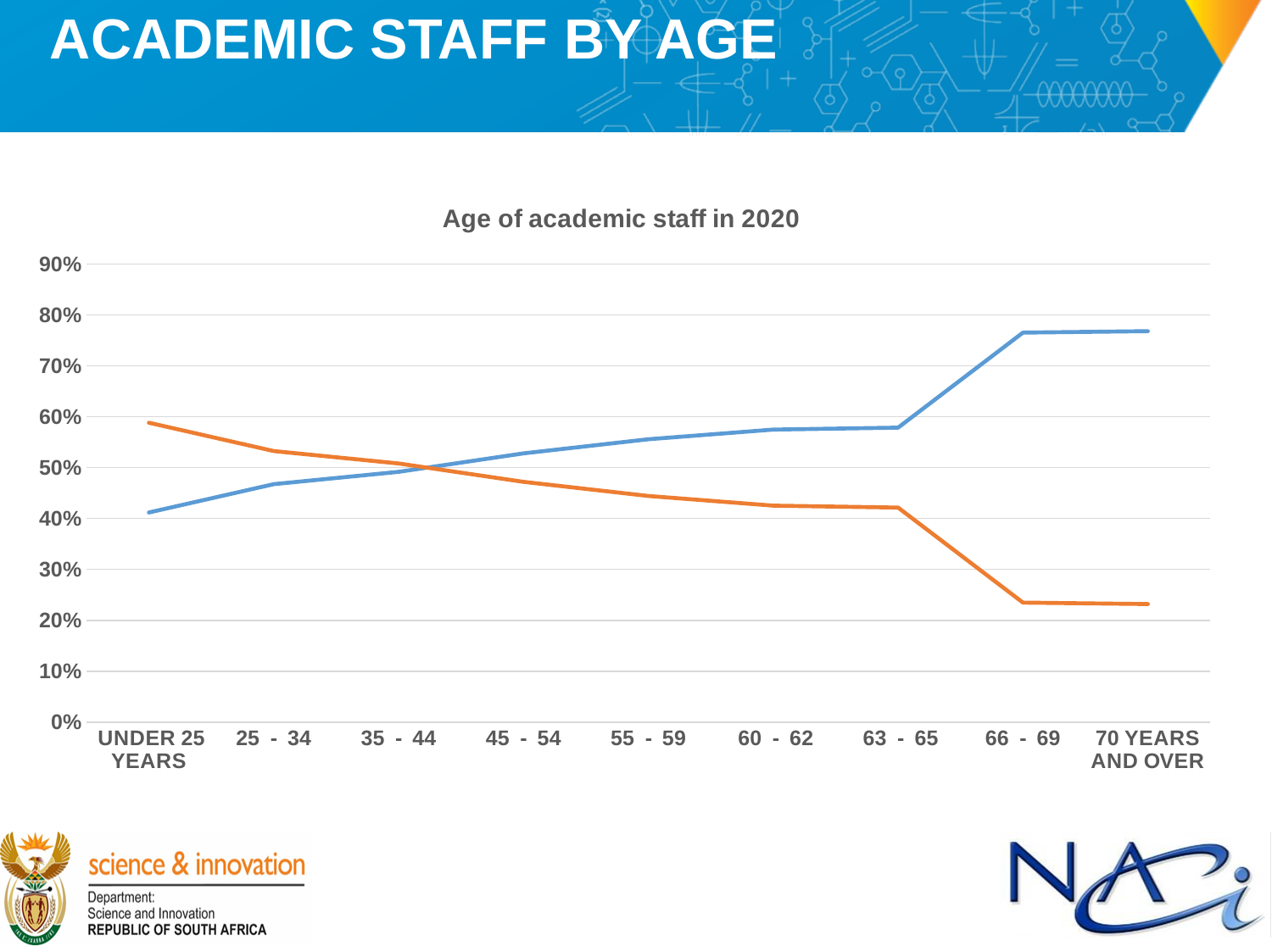
For which age category is the orange line at its highest? UNDER 25 YEARS Is the value of the blue line for 66 - 69 greater or less than 70%? greater Is the value of the blue line for UNDER 25 YEARS greater or less than 50%? less Does the blue line rise or fall from UNDER 25 YEARS to 70 YEARS AND OVER? rise What is the title of the chart? Age of academic staff in 2020 At 60 - 62, which line has the higher value, the blue line or the orange line? the blue line Does the orange line rise or fall from UNDER 25 YEARS to 70 YEARS AND OVER? fall What kind of chart is shown on the slide? line chart How many lines are plotted on the chart? 2 Is the value of the orange line for UNDER 25 YEARS greater or less than 50%? greater How many age categories are shown on the x axis? 9